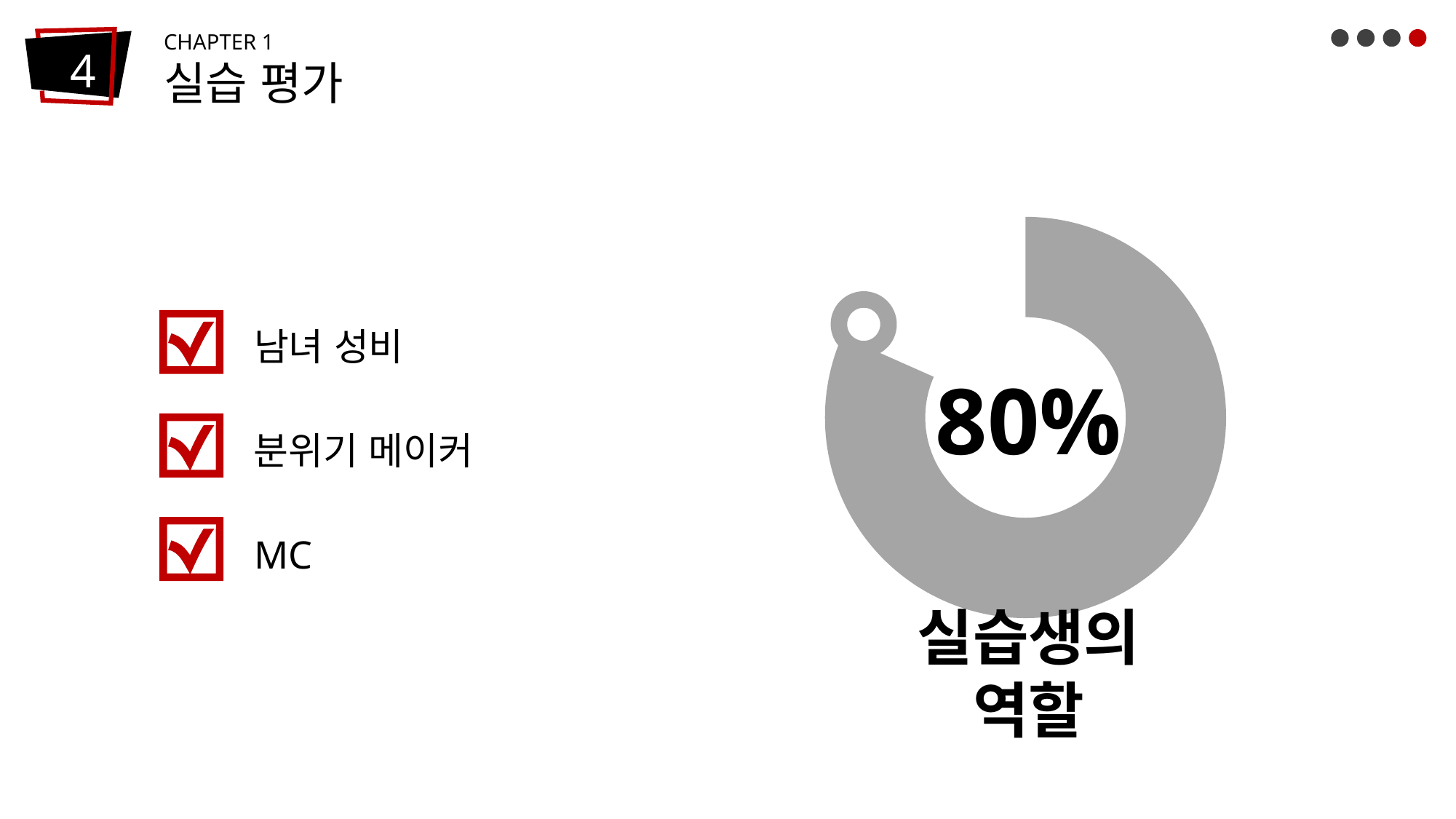
What colour is the ring of the chart? grey What kind of chart is shown on the right of the slide? donut chart What percentage value is printed in the centre of the ring chart? 80% What label is written beneath the ring chart? 실습생의 역할 How many data values are displayed on the ring chart? 1 What share of the ring does the chart indicate for 실습생의 역할? 80%